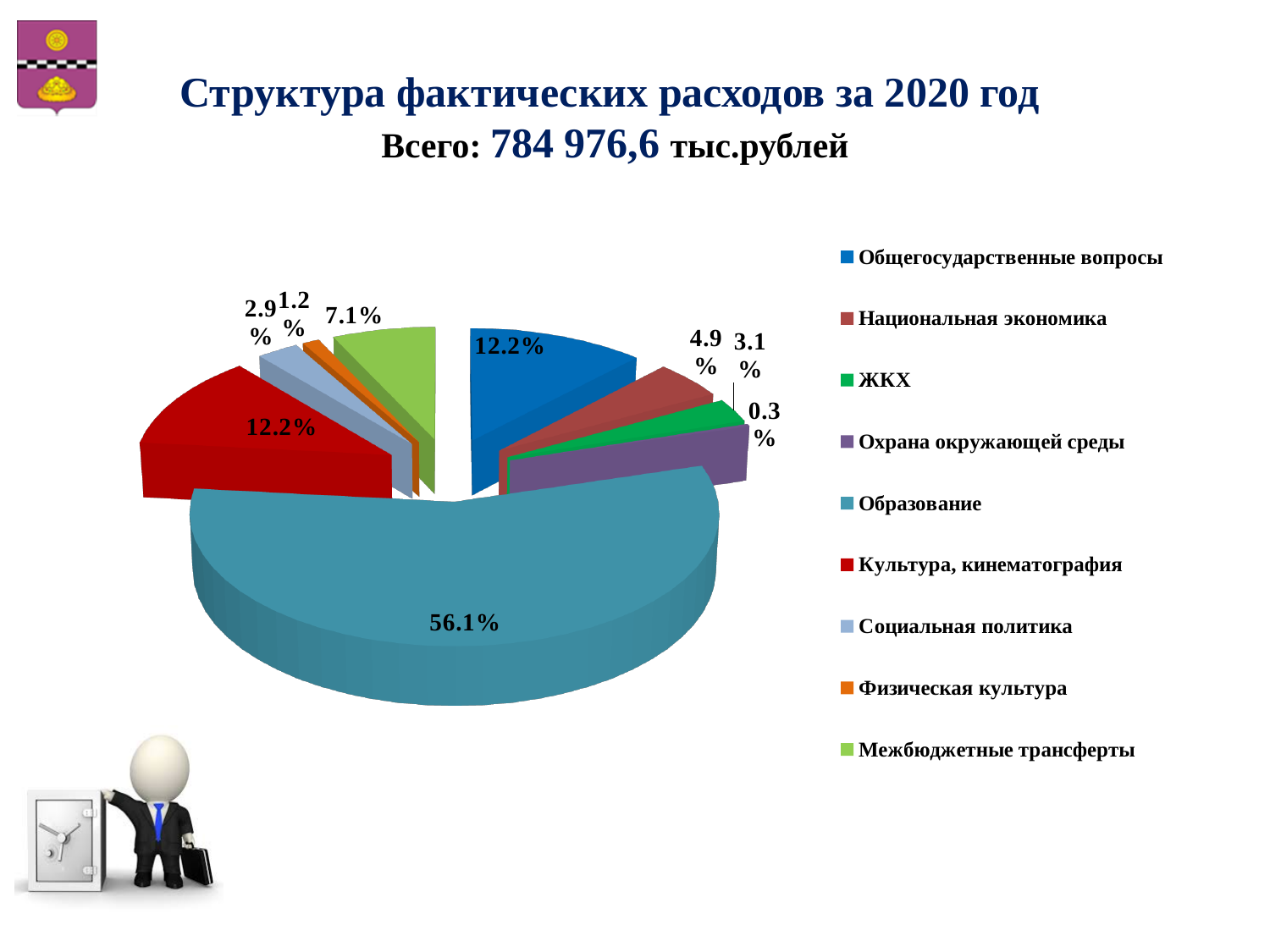
What share of the pie does Образование have? 56.1% What is the value shown for Общегосударственные вопросы? 12.2% Which is larger, the share for ЖКХ or the share for Социальная политика? ЖКХ Which category has the largest share of the pie? Образование What is the value shown for Национальная экономика? 4.9% Which category has the smallest share of the pie? Охрана окружающей среды What kind of chart is shown on the slide? pie chart What is the value shown for Межбюджетные трансферты? 7.1% What is the difference between the share for Межбюджетные трансферты and the share for Физическая культура? 5.9% What total amount is stated in the slide title? 784 976,6 тыс.рублей What is the value shown for Охрана окружающей среды? 0.3% How many categories does the legend list? 9